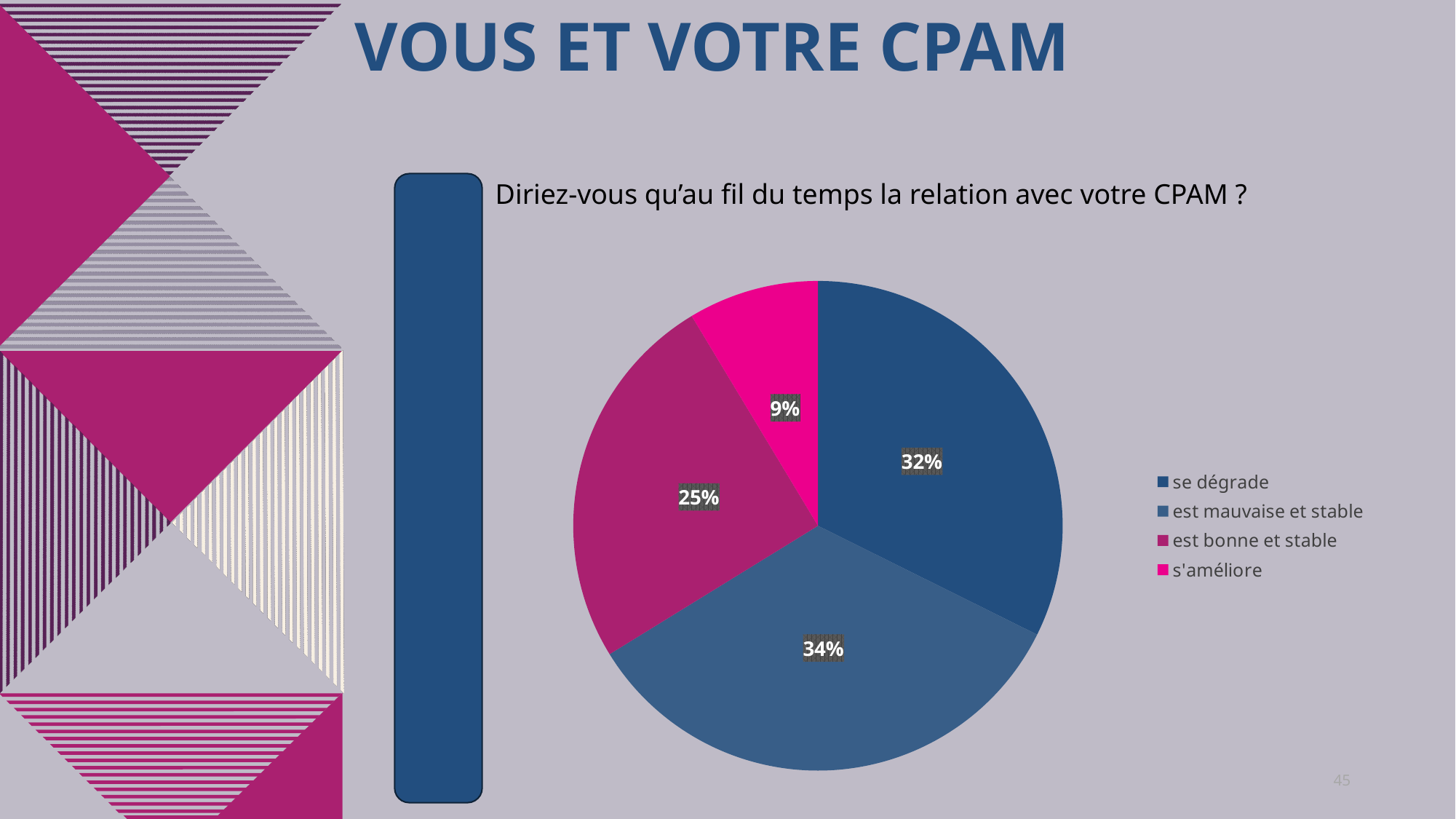
What question is the pie chart answering, as written above it? Diriez-vous qu'au fil du temps la relation avec votre CPAM ? How many categories does the legend list? 4 What is the difference in percentage points between 'est mauvaise et stable' and 'se dégrade'? 2 What percentage of respondents said the relation 's'améliore'? 9% What is the difference in percentage points between 'est bonne et stable' and 's'améliore'? 16 What percentage of respondents said the relation with their CPAM 'se dégrade'? 32% What type of chart is shown on the slide? pie chart What percentage of respondents said the relation 'est mauvaise et stable'? 34% Which category has the largest share of the pie? est mauvaise et stable Which category has the smallest share of the pie? s'améliore Which is larger: the share for 'est bonne et stable' or the share for 's'améliore'? est bonne et stable What percentage of respondents said the relation 'est bonne et stable'? 25%